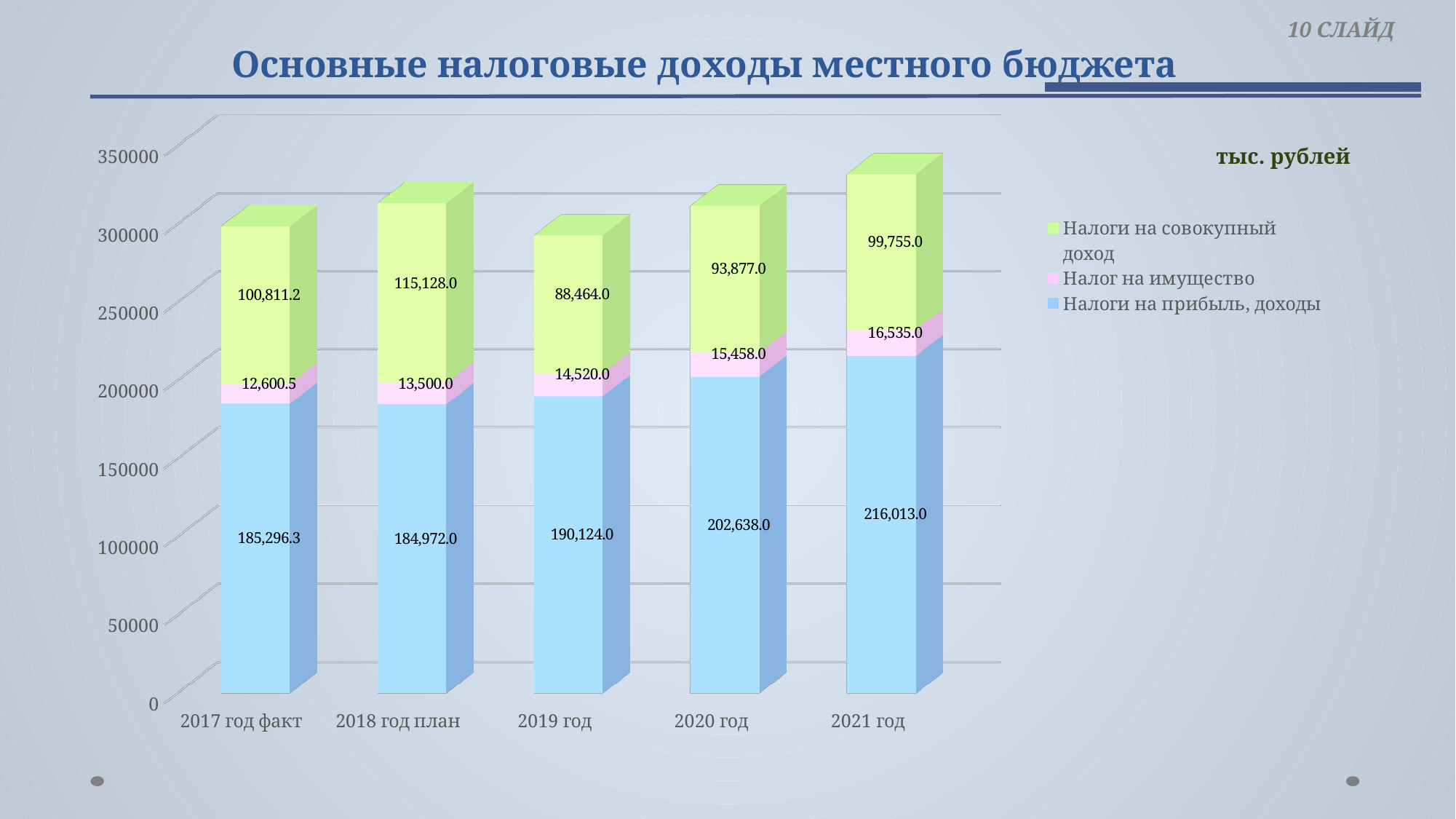
What is the value for "Налог на имущество" in 2017 год факт? 12,600.5 What is the value for "Налоги на совокупный доход" in 2019 год? 88,464.0 What is the total of the stacked bar for 2021 год? 332,303.0 What is the value for "Налоги на прибыль, доходы" in 2021 год? 216,013.0 What is the difference between the "Налоги на прибыль, доходы" values for 2021 год and 2017 год факт? 30,716.7 What kind of chart is shown on the slide? Stacked bar chart How many categories are shown on the x axis? 5 Do the values for "Налог на имущество" rise or fall from 2017 год факт to 2021 год? Rise In which category is the value for "Налоги на совокупный доход" the highest? 2018 год план In which category is the value for "Налоги на прибыль, доходы" the lowest? 2018 год план How many series does the legend list? 3 Which is larger: "Налоги на совокупный доход" in 2020 год or in 2021 год? 2021 год